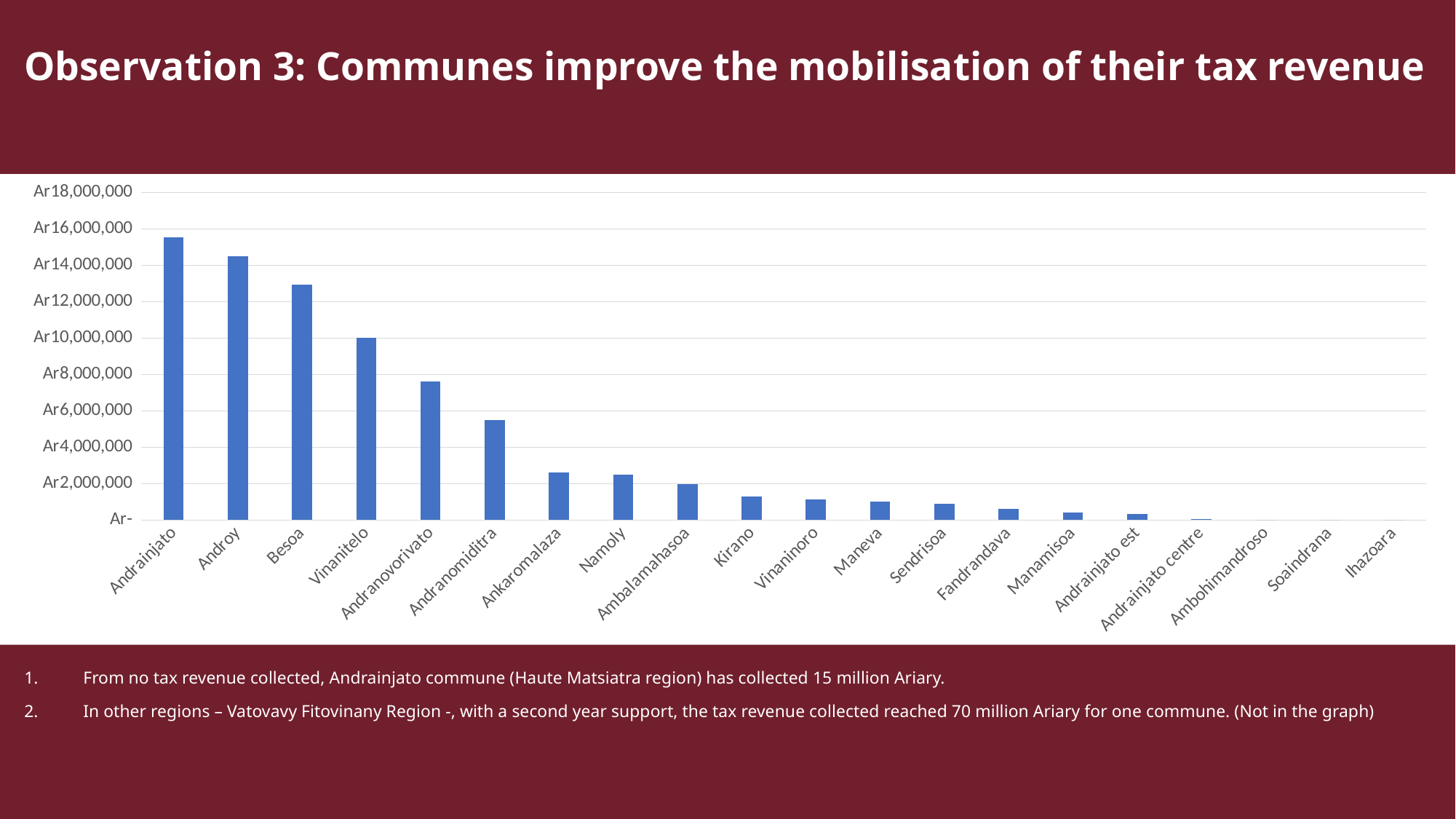
Which has the larger value, Besoa or Vinanitelo? Besoa Is the value for Kirano greater or less than Ar2,000,000? less Is the value for Andrainjato greater or less than Ar14,000,000? greater Is the value for Ankaromalaza greater or less than Ar2,000,000? greater What kind of chart is shown on the slide? bar chart Which commune has the highest tax revenue in the chart? Andrainjato Do the values rise or fall moving from left to right along the x axis? fall How many communes are shown on the x axis of the chart? 20 Which has the larger value, Androy or Andranovorivato? Androy